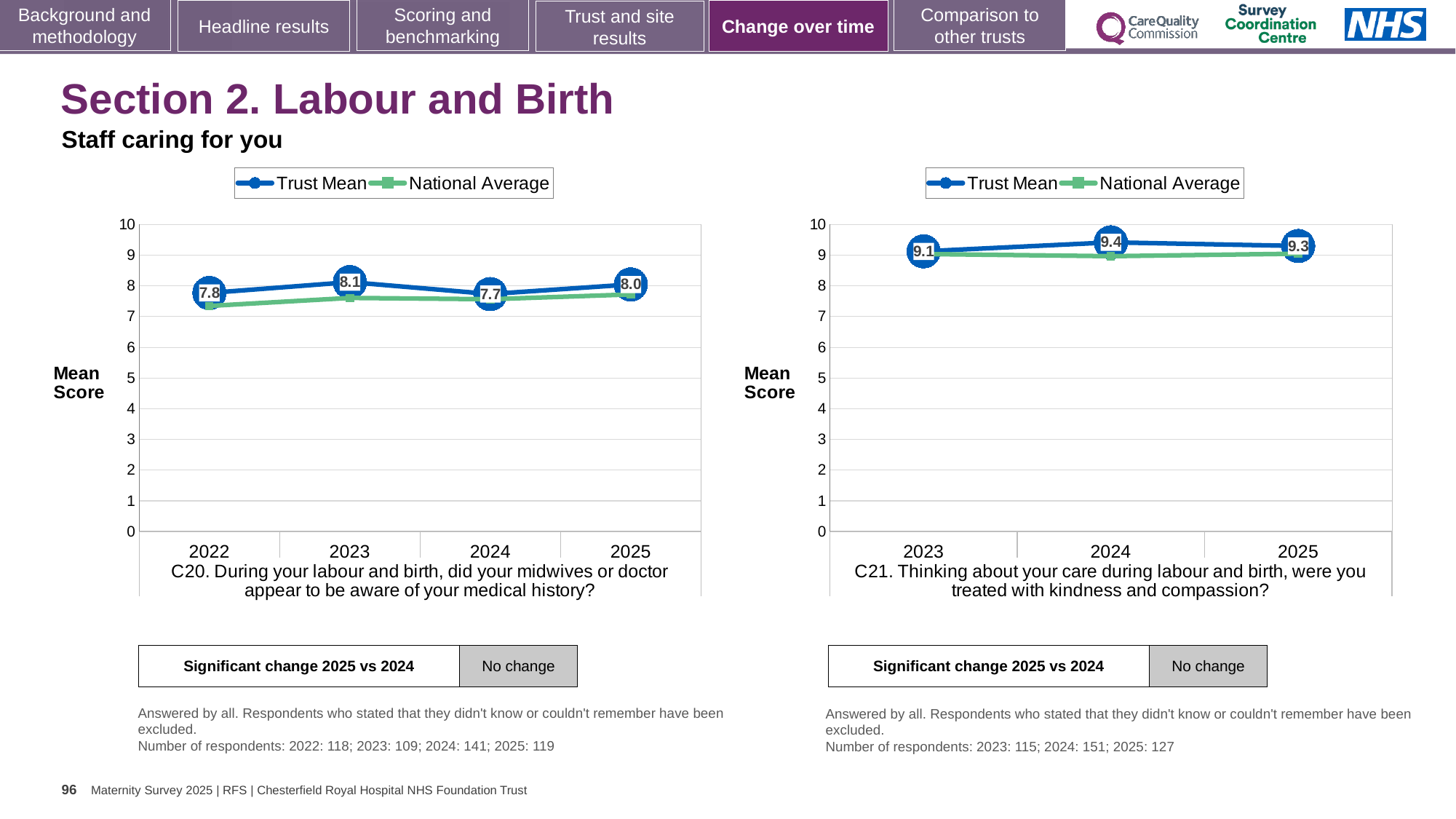
In the C20 chart (left), which year has the lowest Trust Mean? 2024 In the C20 chart (left), what is the Trust Mean for 2023? 8.1 In the C21 chart (right), which year has the highest Trust Mean? 2024 In the C21 chart (right), is the Trust Mean higher in 2024 or in 2025? 2024 In the C20 chart (left), is the National Average for 2022 greater or less than 8? less In the C20 chart (left), what is the difference between the Trust Mean in 2023 and in 2024? 0.4 In the C21 chart (right), what is the Trust Mean for 2023? 9.1 How many years are plotted on the x axis of the C21 chart (right)? 3 In the C20 chart (left), what is the Trust Mean for 2025? 8.0 How many series does the legend of the C20 chart (left) list? 2 What type of chart is used for C20 (left)? Line chart In the C21 chart (right), what is the Trust Mean for 2024? 9.4